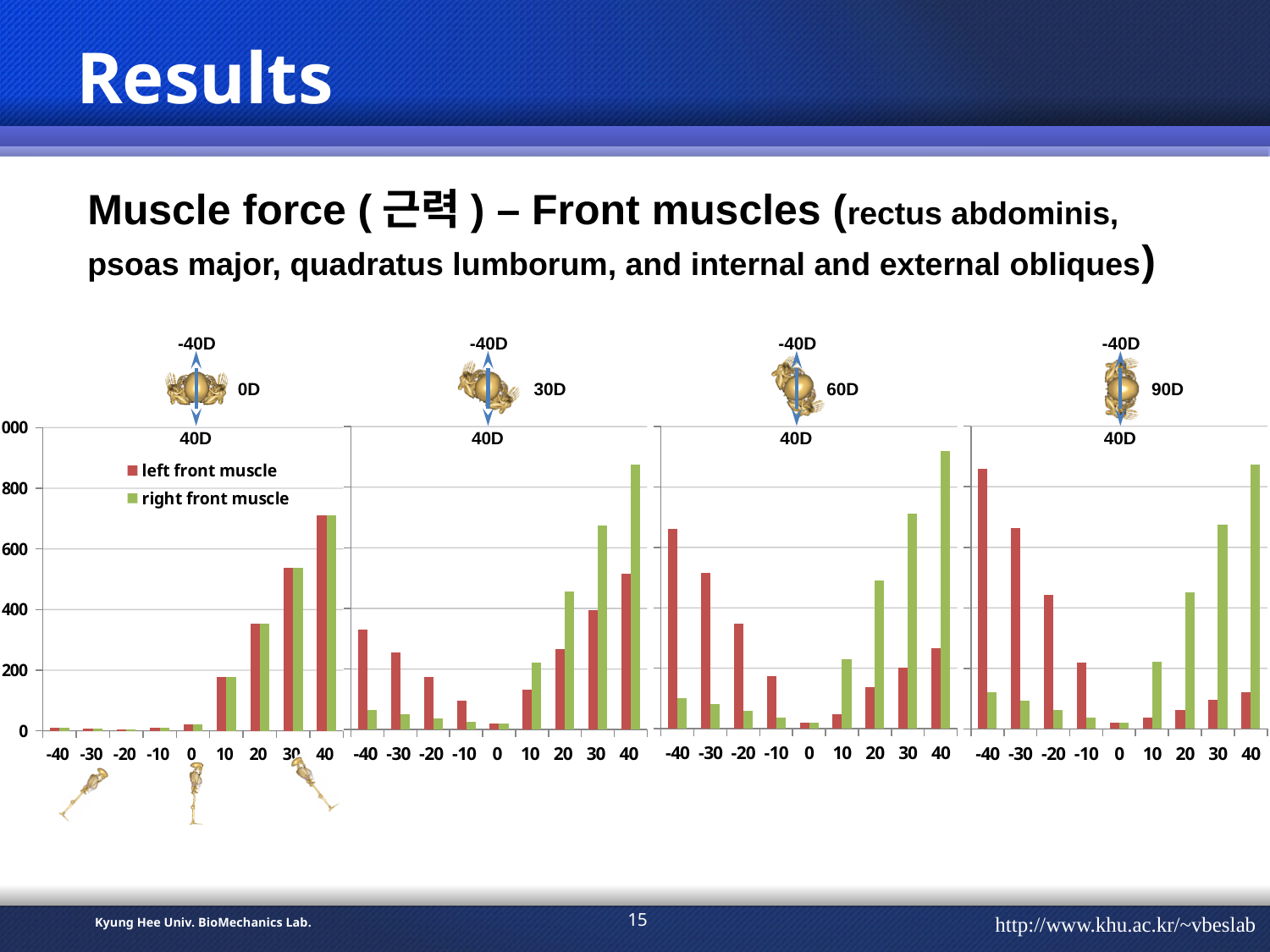
In the 60D chart, is the value for left front muscle at -40 greater or less than 600? greater In the 0D chart, is the value for left front muscle at 40 greater or less than 600? greater How many x-axis categories does the 30D chart have? 9 In the 0D chart, at which x-axis category is the left front muscle value highest? 40 In the 90D chart, at which x-axis category is the left front muscle value highest? -40 What kind of chart is the 0D chart? bar chart In the 30D chart, is the value for right front muscle at 40 greater or less than 800? greater In the 0D chart, do the left front muscle values rise or fall as the x axis goes from -40 to 40? rise How many series does the legend on the 0D chart list? 2 Which colour represents the right front muscle series in the charts? green In the 90D chart, which is larger: the left front muscle value at -40 or the left front muscle value at 0? -40